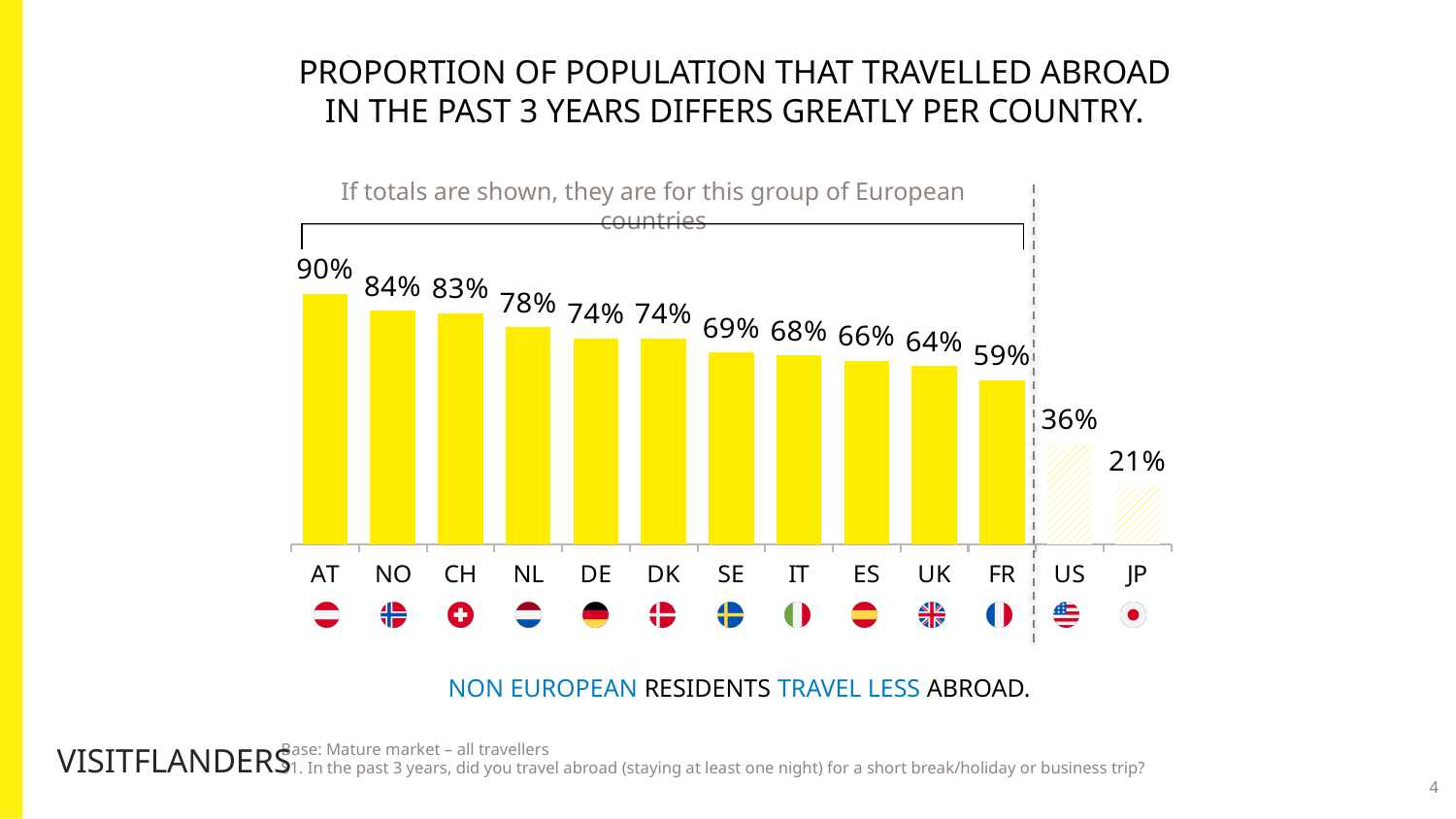
Which two countries both have a value of 74%? DE and DK Which country has the highest value? AT What kind of chart is this? bar chart What is the difference between the values for AT and JP? 69% What is the value for US? 36% What is the difference between the values for NL and UK? 14% Do the values rise or fall from left to right along the x axis? fall Which country has the lowest value? JP What is the value for AT? 90% Which is larger, the value for SE or the value for ES? SE What is the value for FR? 59% How many countries are shown on the chart? 13